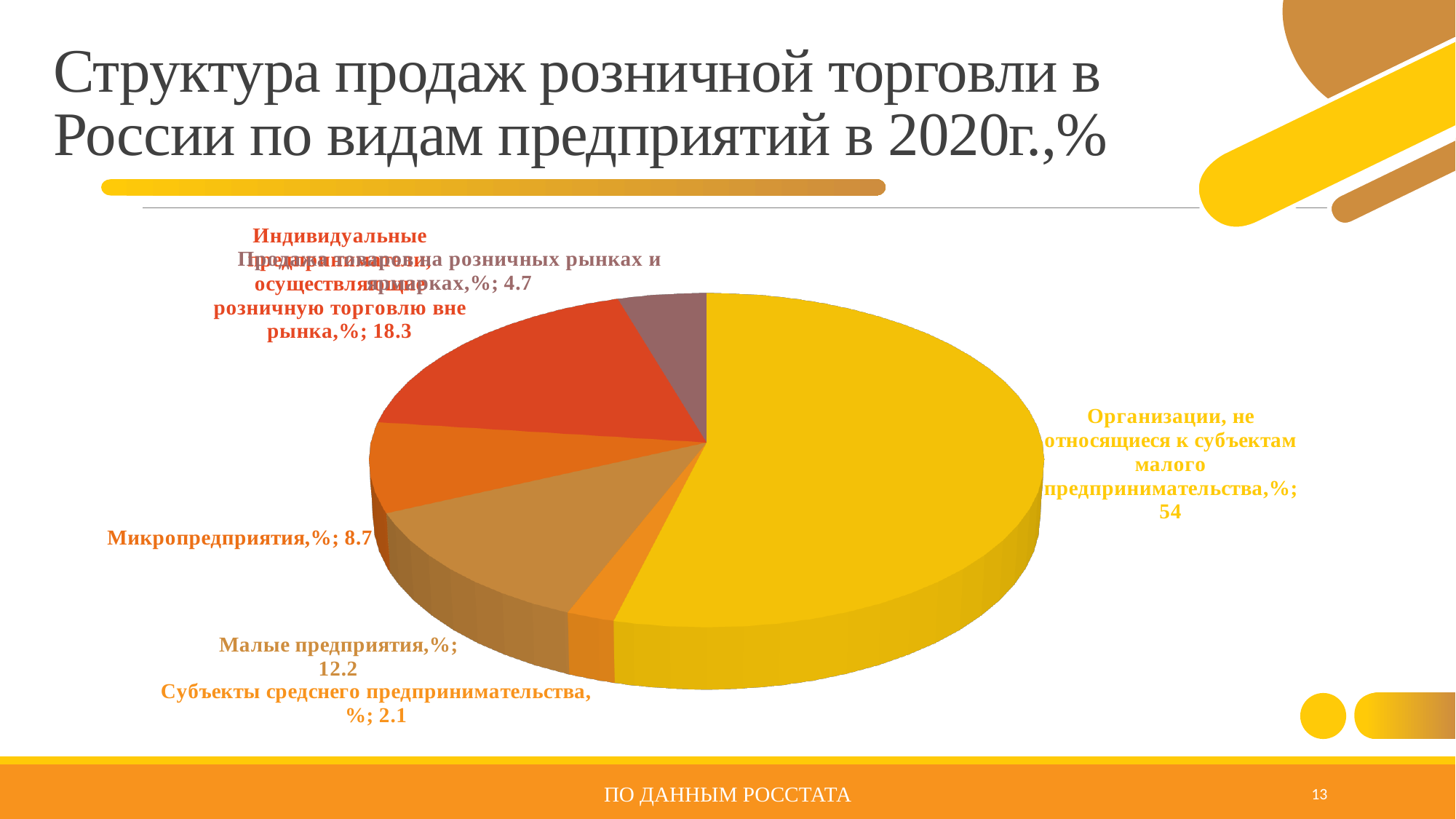
Which is larger: the value for Микропредприятия or the value for Продажа товаров на розничных рынках и ярмарках? Микропредприятия What kind of chart is shown on the slide? pie chart What is the value for Индивидуальные предприниматели, осуществляющие розничную торговлю вне рынка? 18.3 Which category has the largest share of the pie? Организации, не относящиеся к субъектам малого предпринимательства What is the value for Микропредприятия? 8.7 What is the difference between the values for Малые предприятия and Микропредприятия? 3.5 What is the value for Организации, не относящиеся к субъектам малого предпринимательства? 54 Which category has the smallest share of the pie? Субъекты средснего предпринимательства What is the title of the slide? Структура продаж розничной торговли в России по видам предприятий в 2020г.,% What is the value for Малые предприятия? 12.2 What is the value for Продажа товаров на розничных рынках и ярмарках? 4.7 How many slices does the pie chart have? 6